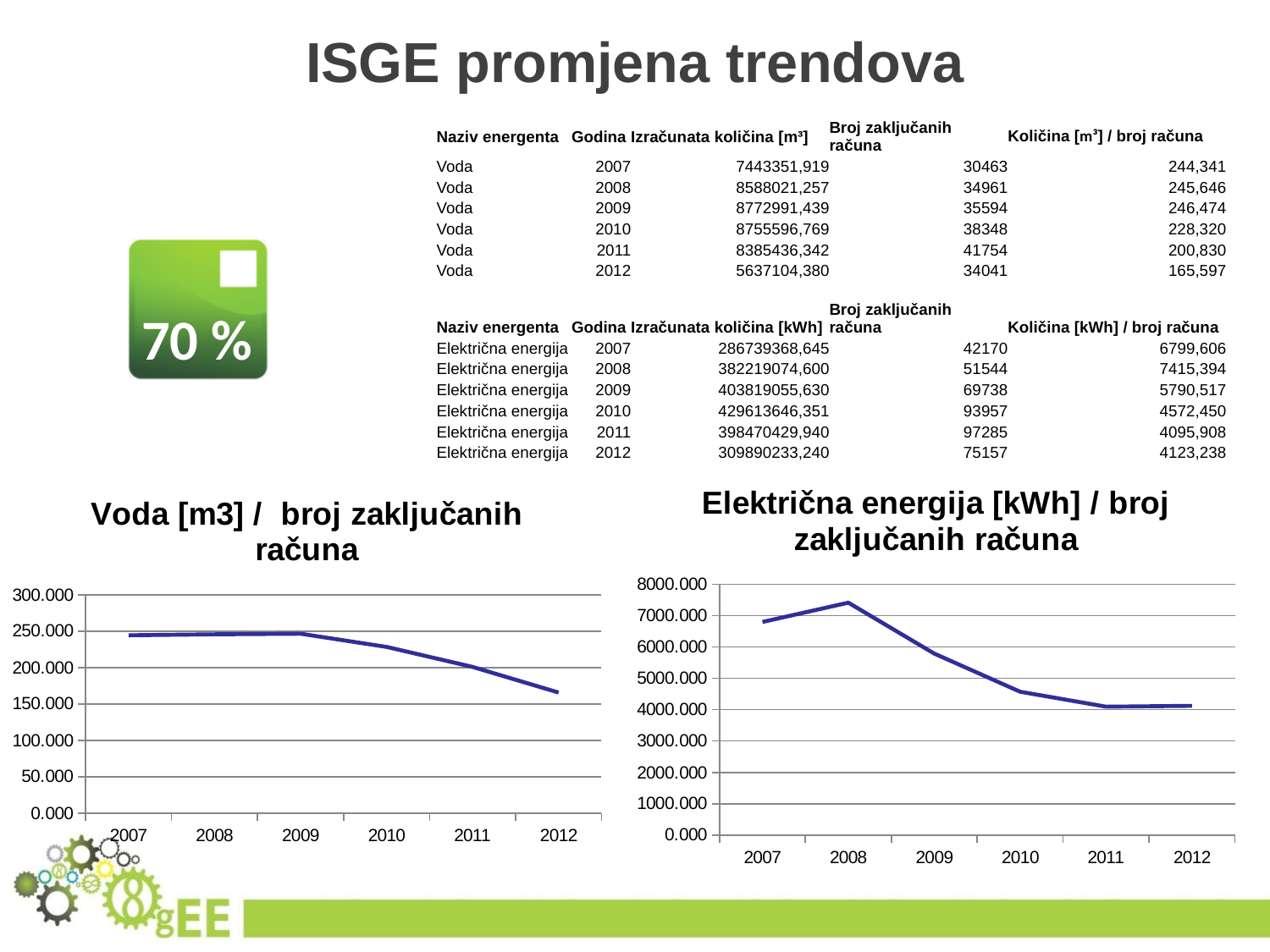
On the 'Voda [m3] / broj zaključanih računa' chart, is the value for 2012 greater or less than 200.000? less On the 'Voda [m3] / broj zaključanih računa' chart, which is larger, the value for 2009 or the value for 2012? 2009 On the 'Voda [m3] / broj zaključanih računa' chart, is the value for 2010 greater or less than 200.000? greater On the 'Električna energija [kWh] / broj zaključanih računa' chart, is the value for 2010 greater or less than 5000.000? less What kind of chart is the 'Voda [m3] / broj zaključanih računa' chart? line chart How many years are plotted on the 'Električna energija [kWh] / broj zaključanih računa' chart? 6 What is the title of the chart on the left side of the slide? Voda [m3] / broj zaključanih računa On the 'Električna energija [kWh] / broj zaključanih računa' chart, do the values rise or fall from 2008 to 2011? fall On the 'Voda [m3] / broj zaključanih računa' chart, which year has the lowest value? 2012 On the 'Električna energija [kWh] / broj zaključanih računa' chart, which is larger, the value for 2007 or the value for 2011? 2007 On the 'Električna energija [kWh] / broj zaključanih računa' chart, which year has the highest value? 2008